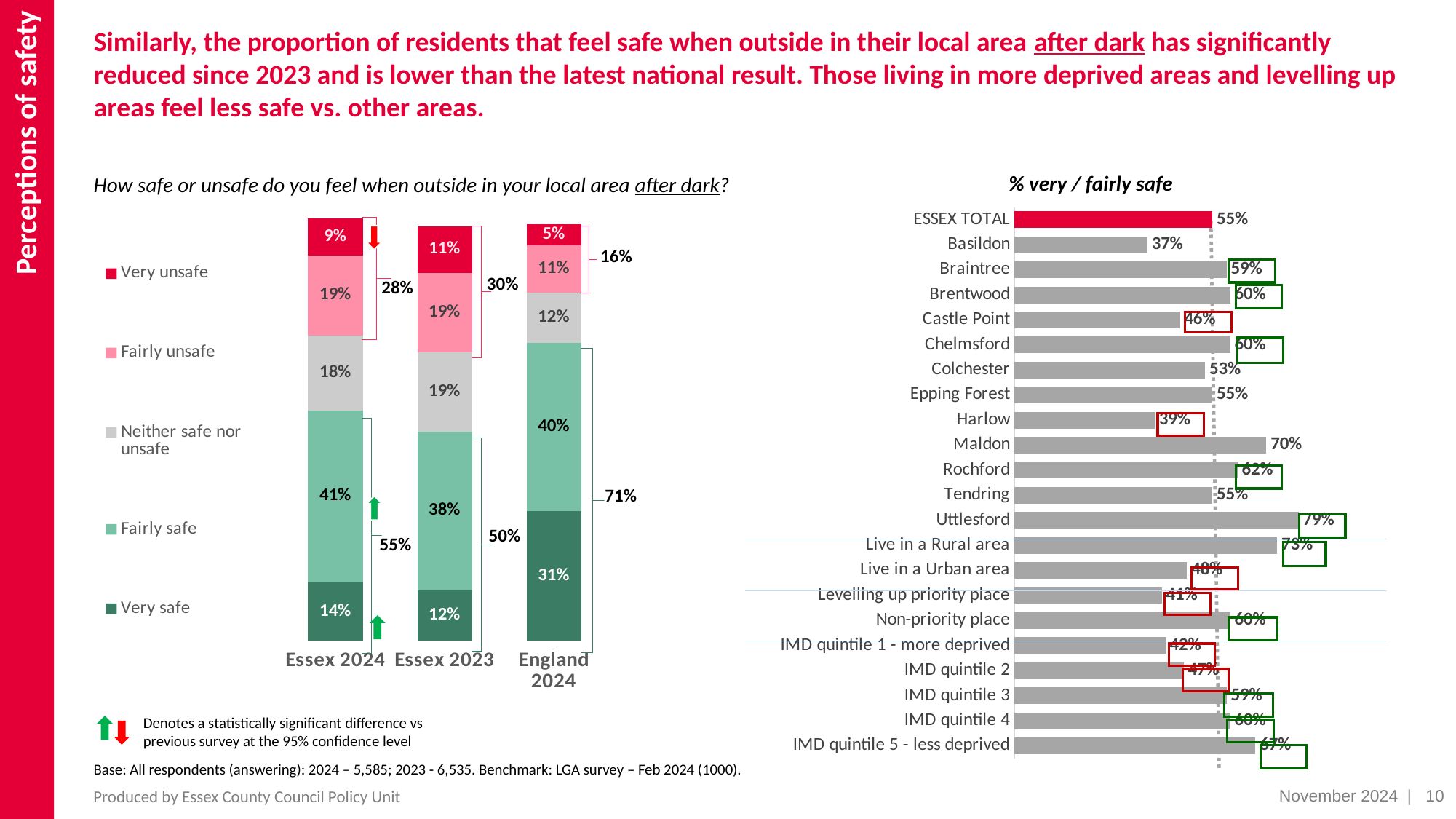
In the left chart, which bar has the larger 'neither safe nor unsafe' share, Essex 2023 or England 2024? Essex 2023 In the left chart, what percentage of England 2024 respondents said they feel very unsafe? 5% In the '% very / fairly safe' chart, which category has the lowest value? Basildon In the left chart, what percentage of Essex 2024 respondents said they feel very safe outside after dark? 14% In the '% very / fairly safe' chart, what is the value for Basildon? 37% What kind of chart is the '% very / fairly safe' chart on the right? Bar chart In the left chart, what is the combined very/fairly safe figure shown for Essex 2023? 50% In the '% very / fairly safe' chart, which district has the highest value? Uttlesford In the left chart, what is the difference between the fairly safe percentages for Essex 2024 and Essex 2023? 3% How many series does the legend of the left chart list? 5 In the '% very / fairly safe' chart, what is the difference between Maldon and Harlow? 31% In the '% very / fairly safe' chart, what is the value for ESSEX TOTAL? 55%